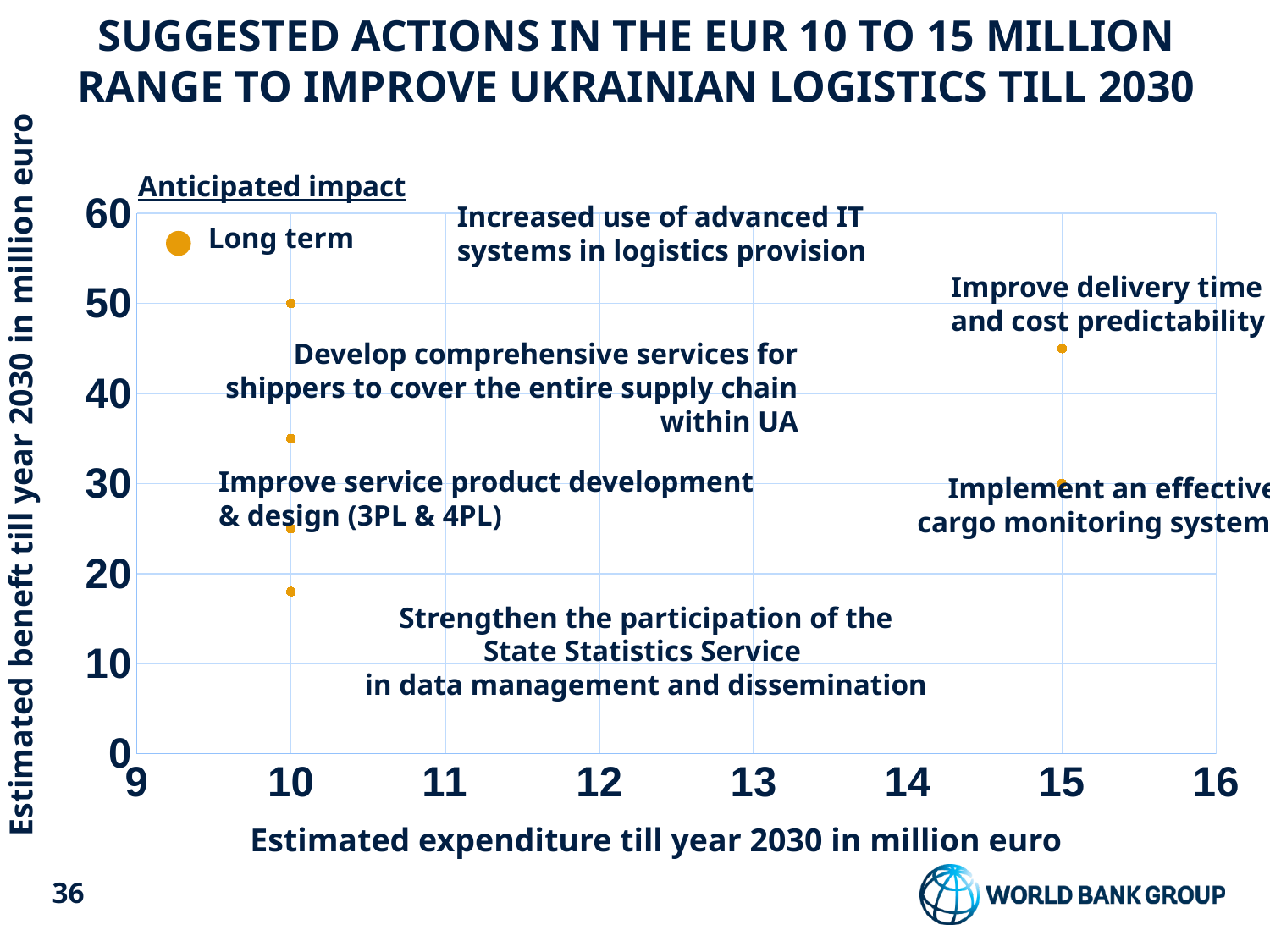
What is the estimated expenditure for 'Improve delivery time and cost predictability'? 15 Which action has the highest estimated benefit till year 2030? Increased use of advanced IT systems in logistics provision What is the label of the x axis? Estimated expenditure till year 2030 in million euro What is the estimated benefit for 'Implement an effective cargo monitoring system'? 30 How many data points are plotted on the chart? 6 What is the estimated expenditure for 'Increased use of advanced IT systems in logistics provision'? 10 Which action has the lowest estimated benefit till year 2030? Strengthen the participation of the State Statistics Service in data management and dissemination What is the estimated benefit for 'Increased use of advanced IT systems in logistics provision'? 50 Is the estimated benefit for 'Improve delivery time and cost predictability' greater or less than 40? greater Which has the larger estimated benefit: 'Improve delivery time and cost predictability' or 'Implement an effective cargo monitoring system'? Improve delivery time and cost predictability What kind of chart is shown on the slide? scatter chart How many series does the legend list? 1